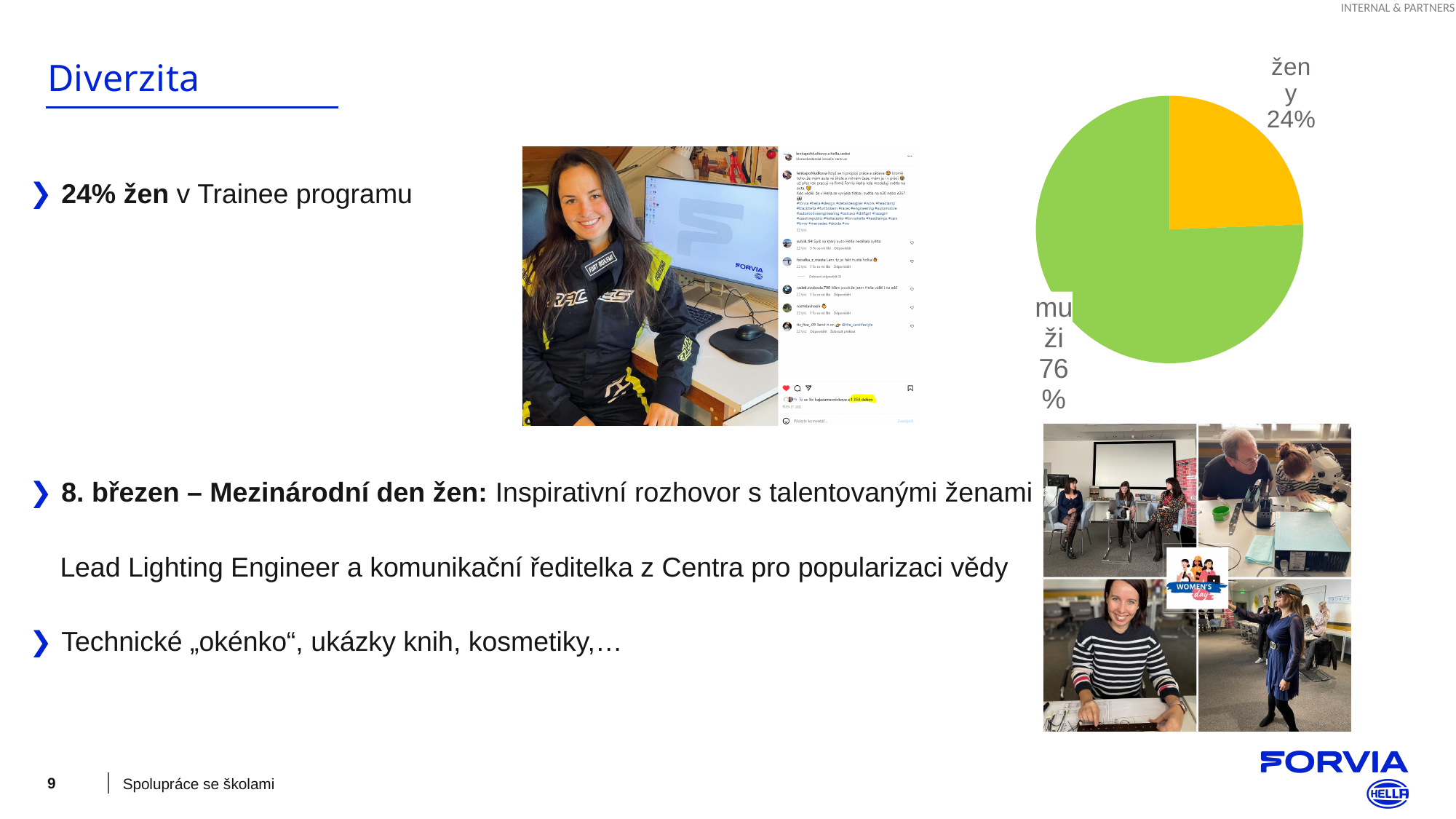
How many slices does the pie chart have? 2 What is the total of the two slices in the pie chart? 100% Which slice of the pie chart is the largest? muži Which slice of the pie chart is the smallest? ženy What colour is the muži slice of the pie chart? green What is the difference in percentage points between the muži and ženy slices? 52 Which slice is larger, muži or ženy? muži What share of the pie chart is labelled "muži"? 76% What kind of chart is shown on the slide? pie chart What colour is the ženy slice of the pie chart? yellow What share of the pie chart is labelled "ženy"? 24%